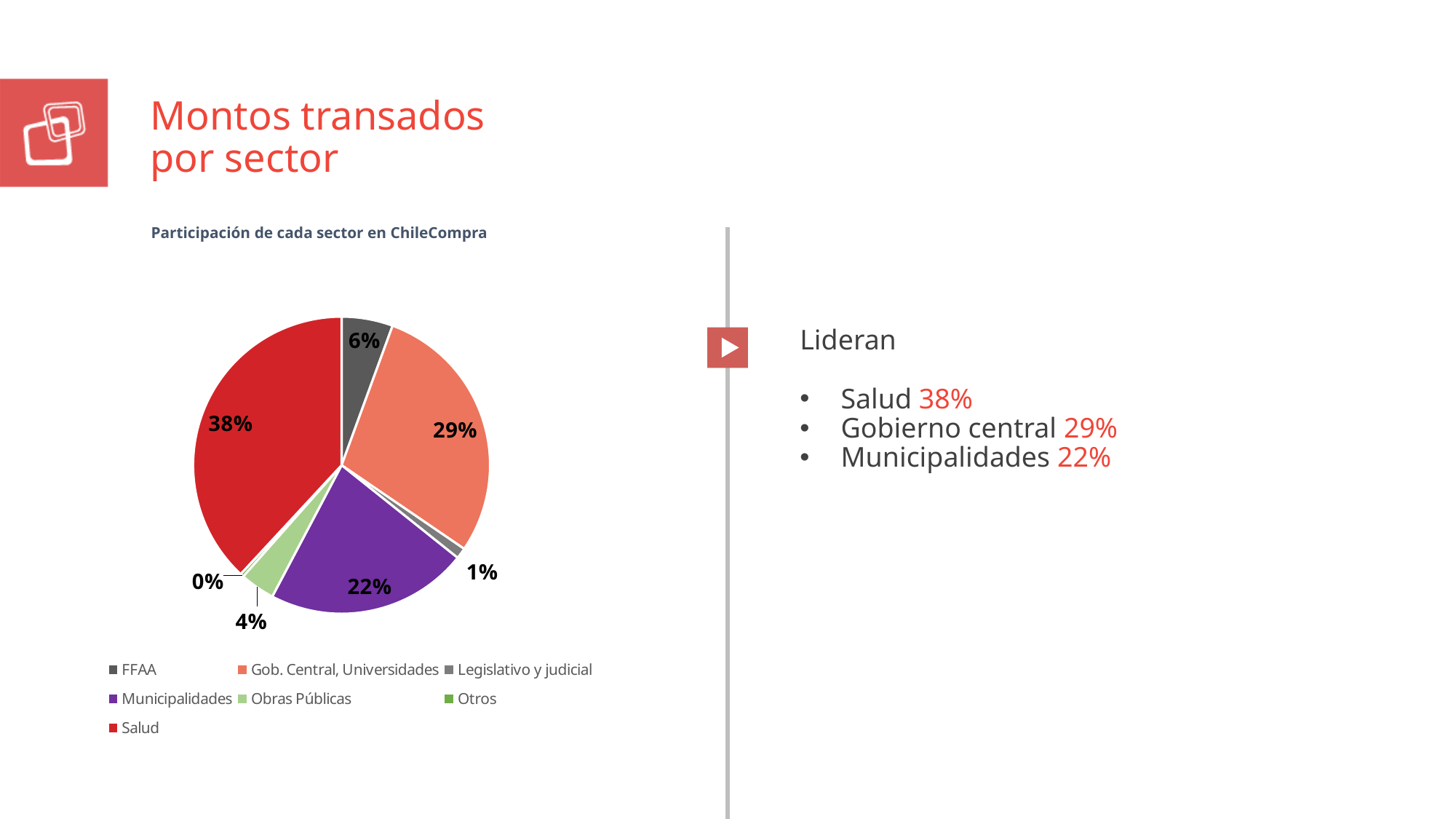
What kind of chart is shown on the slide? Pie chart What share of the pie does Legislativo y judicial have? 1% Which sector has the largest share of the pie? Salud What share of the pie does Gob. Central, Universidades have? 29% What share of the pie does Obras Públicas have? 4% What is the difference in percentage points between Salud and Municipalidades? 16 Which sector has the smallest share of the pie? Otros What is the title of the chart? Participación de cada sector en ChileCompra How many sectors does the legend list? 7